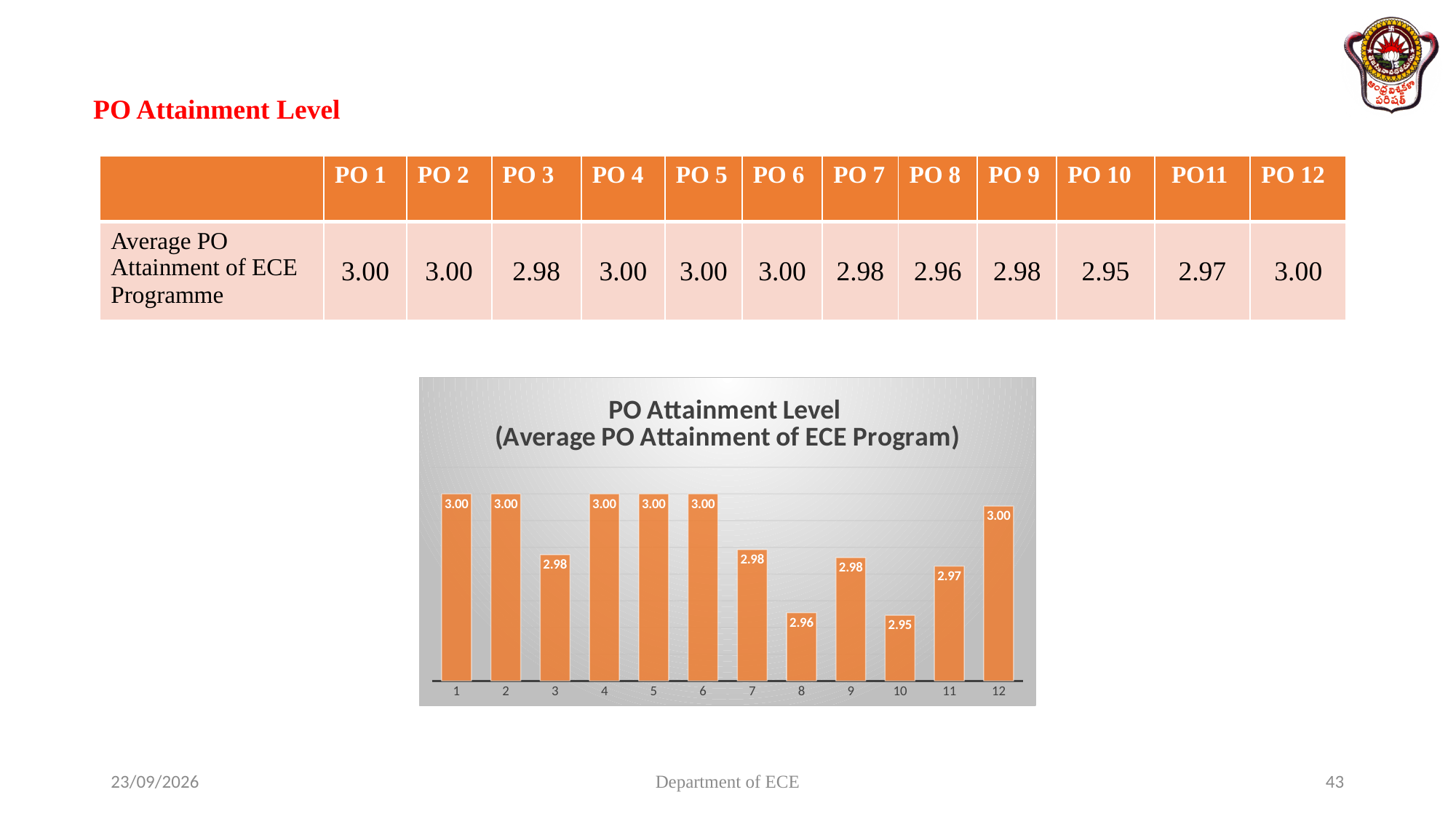
How many categories are shown on the x axis of the chart? 12 What is the value for category 11 in the chart? 2.97 What is the value for category 8 in the chart? 2.96 What is the title of the chart? PO Attainment Level (Average PO Attainment of ECE Program) Which is larger, the value for category 8 or the value for category 10? 8 What is the value for category 3 in the chart? 2.98 Which is larger, the value for category 9 or the value for category 11? 9 What is the difference between the values for category 7 and category 8? 0.02 What is the value for category 10 in the chart? 2.95 What is the difference between the values for category 1 and category 10? 0.05 What kind of chart is shown on the slide? bar chart Which category has the lowest value in the chart? 10